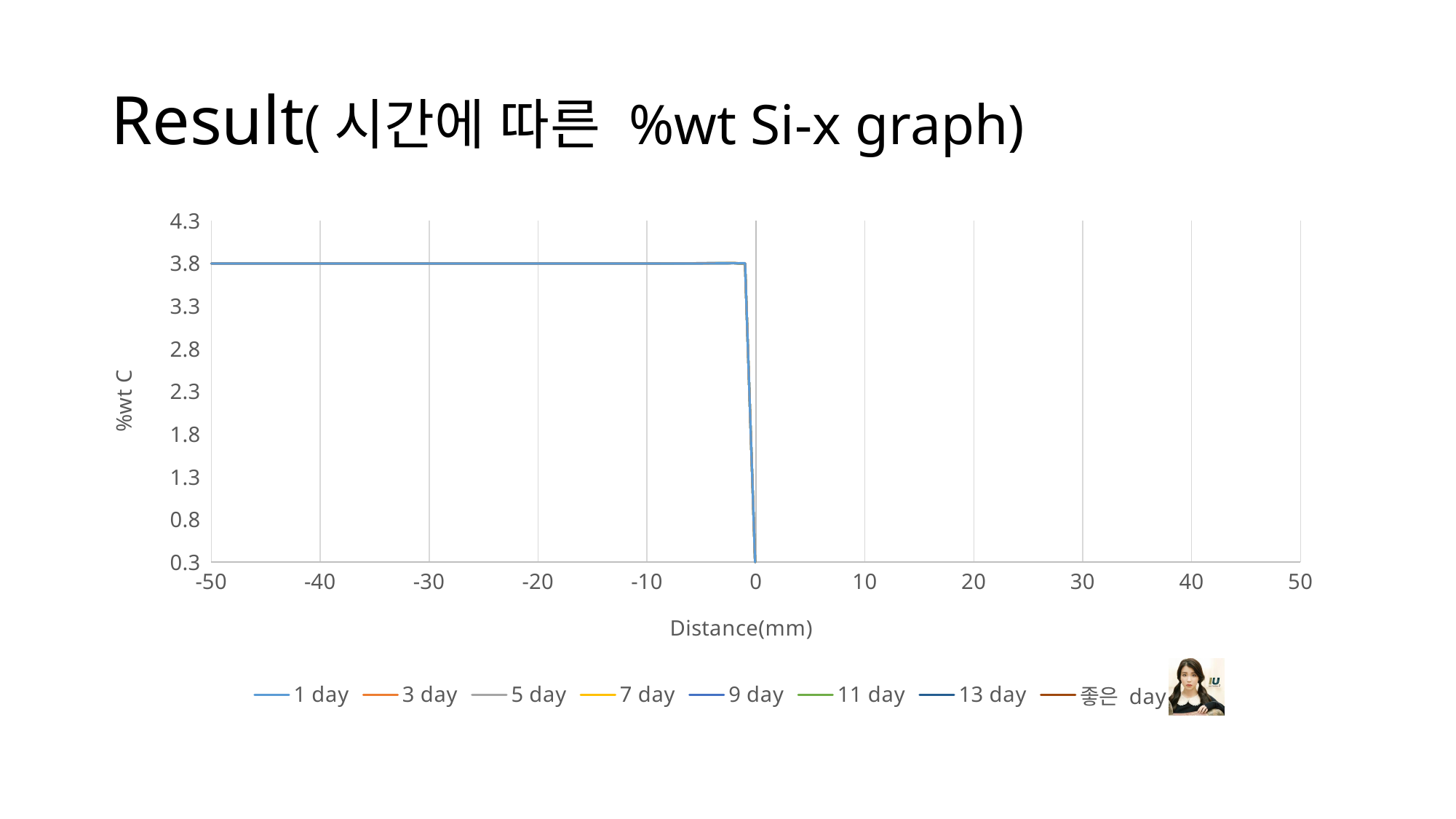
What is the label of the y axis? %wt C How many series does the legend list? 8 Is the value at a distance of 0 mm greater or less than 1.3? less What kind of chart is shown on the slide? line chart Is the value at -40 mm larger or smaller than the value at 0 mm? larger What is the label of the x axis? Distance(mm) Is the value at a distance of -20 mm greater or less than 2.8? greater What is the highest value shown on the y axis? 4.3 Is the value at a distance of -30 mm greater or less than 3.3? greater Does the plotted value rise or fall as the distance approaches 0 mm from the left? fall What value does the plotted line sit at for distances from -50 mm to -10 mm? 3.8